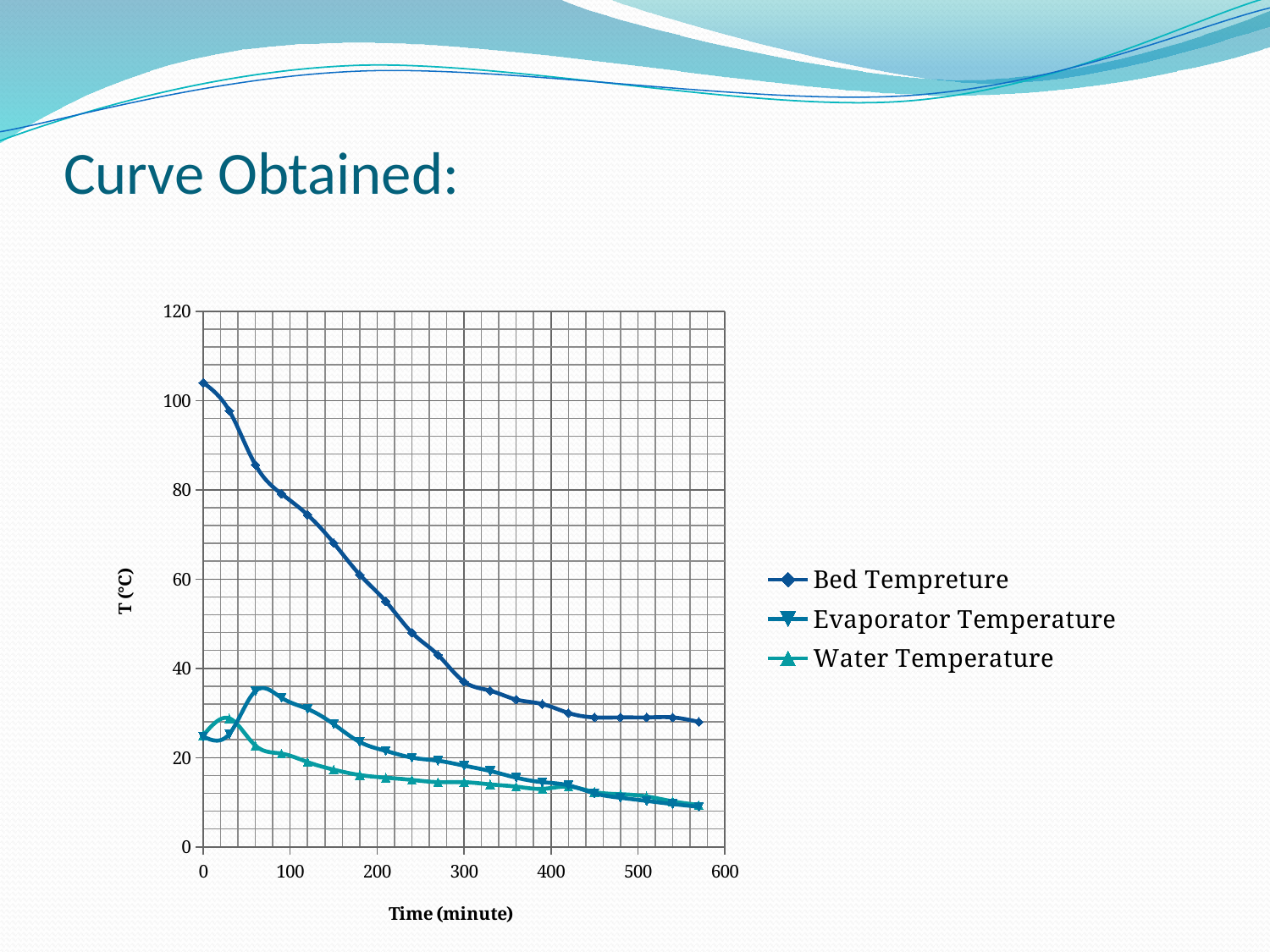
How many series does the legend list? 3 What is the title of the y axis? T (°C) What kind of chart is shown on the slide? line chart What is the title of the x axis? Time (minute) Is the Water Temperature value at time 570 greater or less than 20? less At time 300, which is larger: Bed Tempreture or Water Temperature? Bed Tempreture Does the Bed Tempreture series rise or fall as time increases? fall Is the Evaporator Temperature value at time 60 greater or less than 20? greater Is the Bed Tempreture value at time 300 greater or less than 40? less Which series reaches the highest temperature on the chart? Bed Tempreture